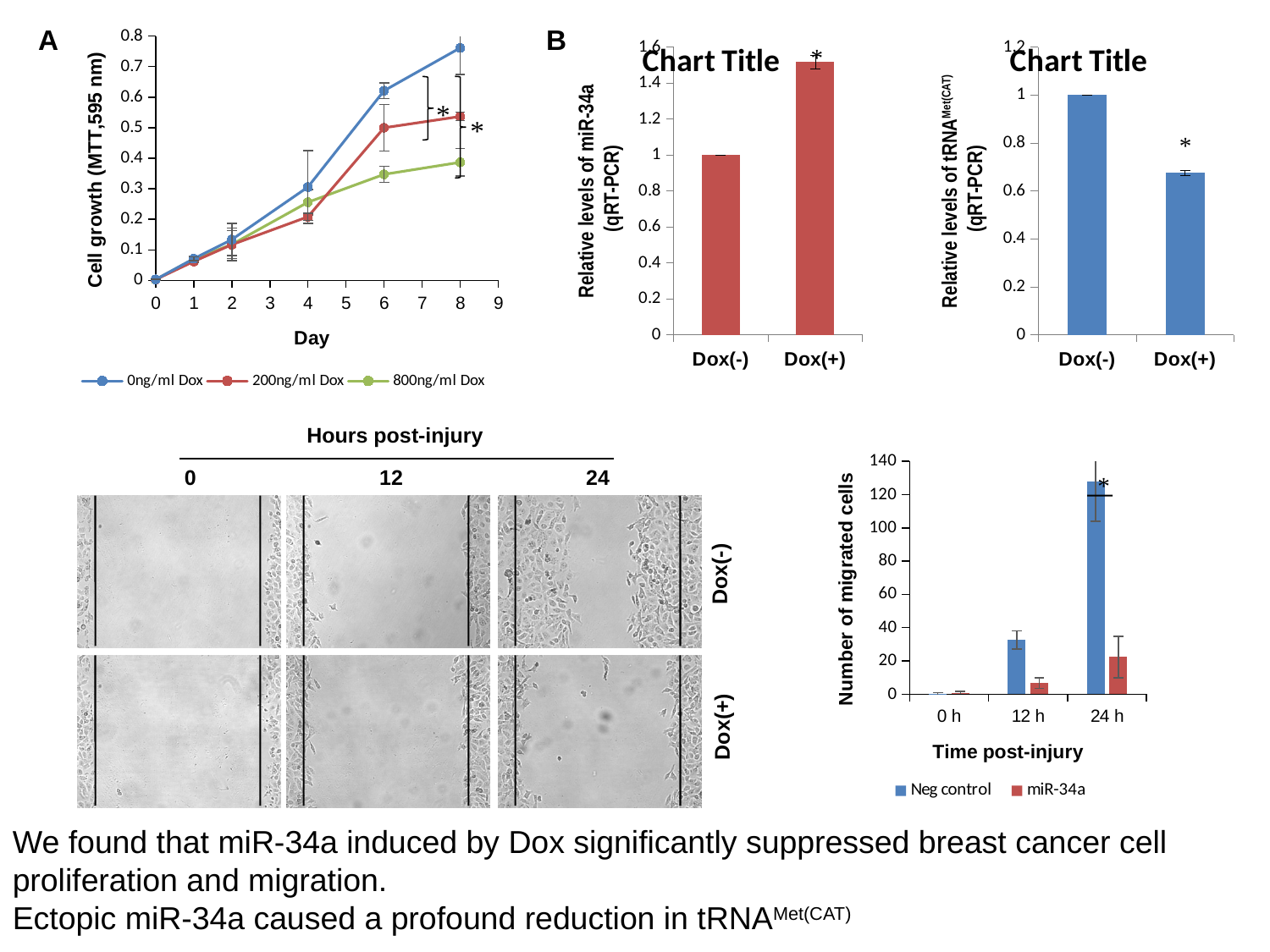
In the panel B chart of relative levels of miR-34a, which is higher, Dox(-) or Dox(+)? Dox(+) What kind of chart is panel A (Cell growth vs Day)? line chart In panel A, how many series does the legend list? 3 In the Number of migrated cells chart, how many series does the legend list? 2 In the Number of migrated cells chart, is the value for Neg control at 24 h greater or less than 100? greater In the panel B chart of relative levels of miR-34a, what is the value for Dox(-)? 1 In the panel B chart of relative levels of miR-34a, is the value for Dox(+) greater or less than 1.4? greater In panel A, is the cell growth for 0ng/ml Dox at day 8 greater or less than 0.7? greater In panel A, which series has the highest cell growth at day 8? 0ng/ml Dox In the panel B chart of relative levels of tRNAMet(CAT), which category has the lowest value? Dox(+) In panel A, does cell growth for 0ng/ml Dox rise or fall from day 0 to day 8? rise